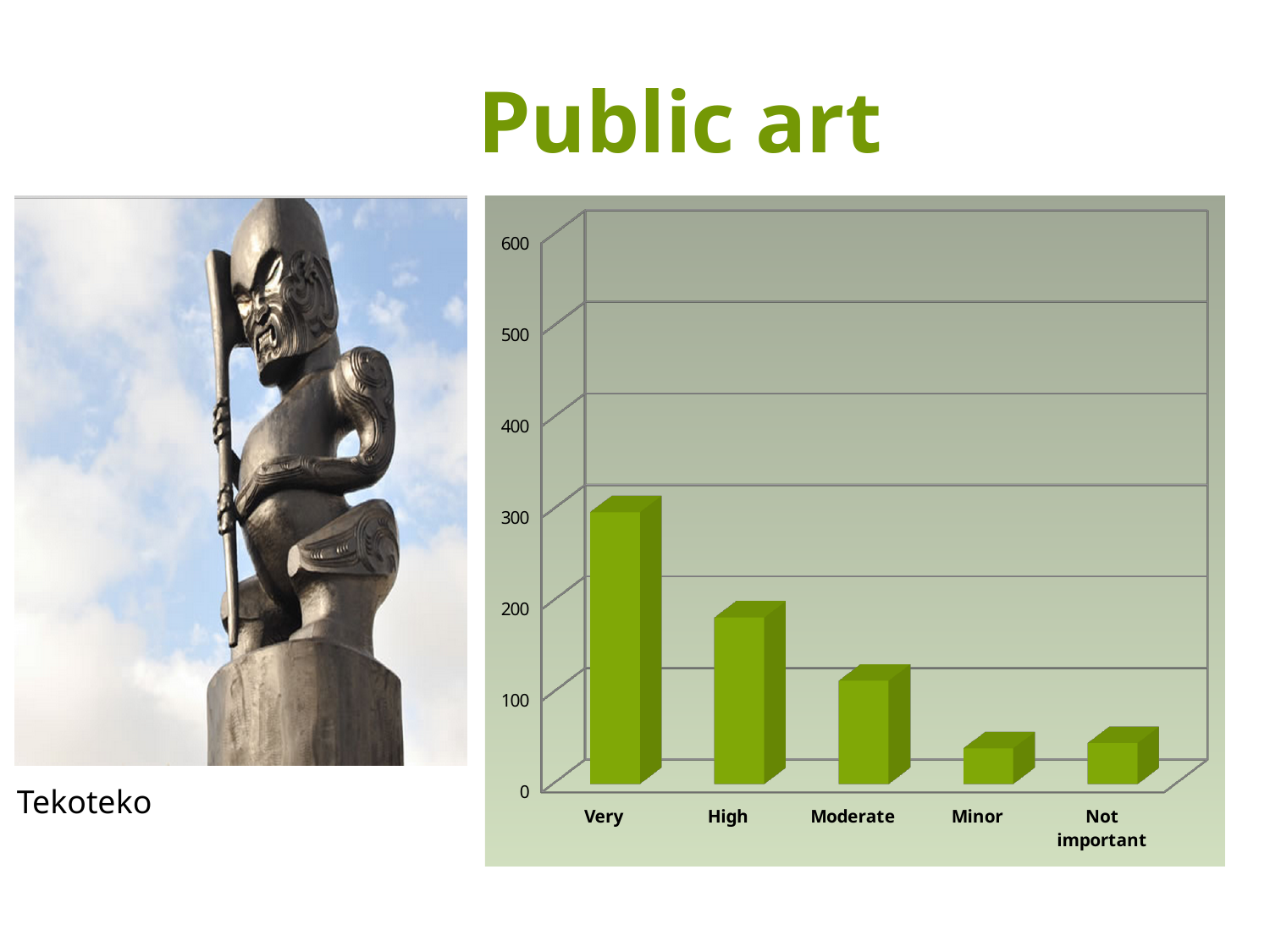
Is the value for High greater or less than 300? less Is the value for High greater or less than 100? greater How many categories are shown on the x axis of the chart? 5 Which category has the highest bar in the chart? Very Is the value for Not important greater or less than 100? less Which is larger, the value for Moderate or the value for Minor? Moderate What is the title of the slide containing the chart? Public art What kind of chart is shown on the slide? bar chart Which is larger, the value for Very or the value for High? Very